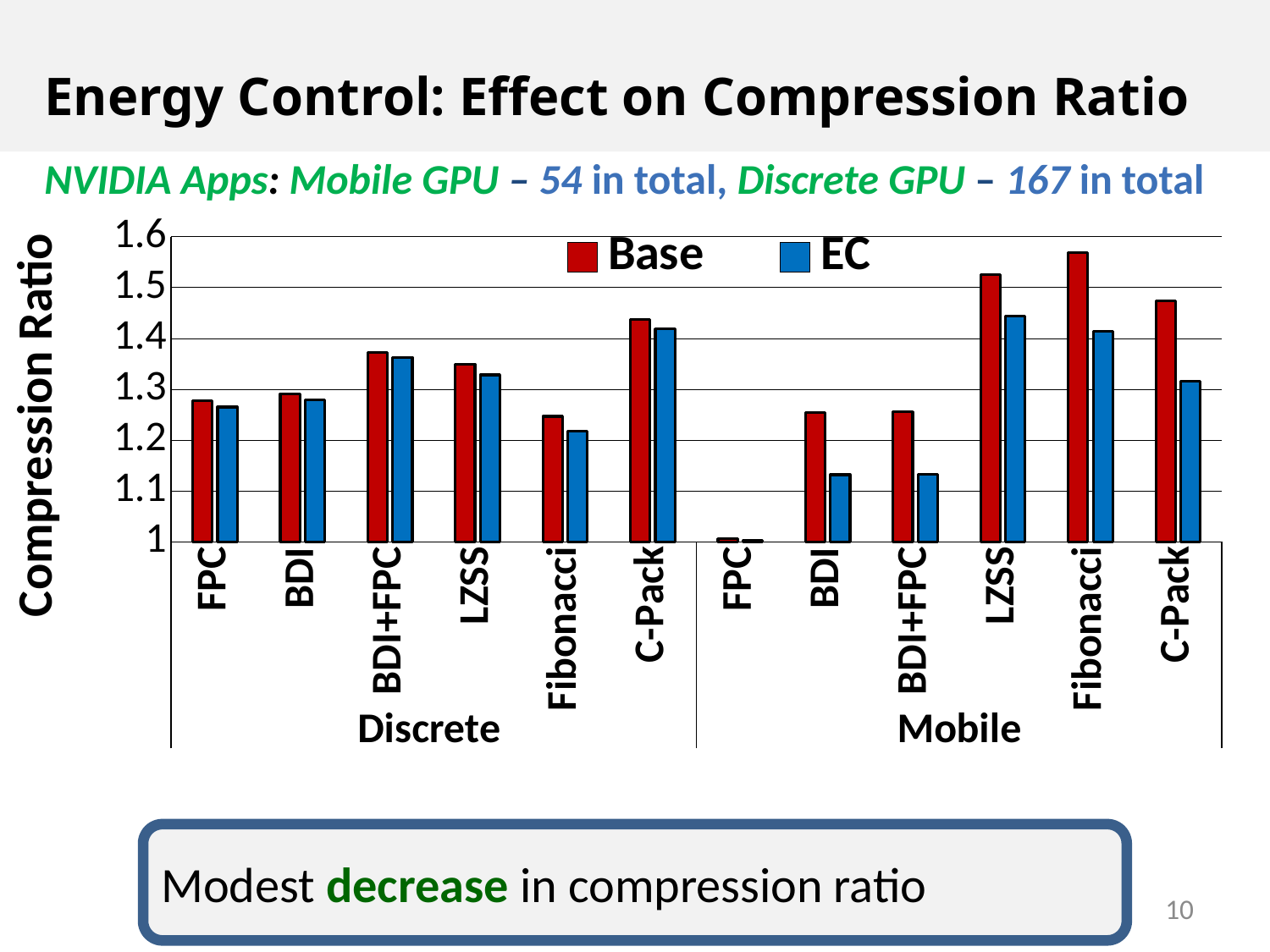
What are the two series named in the legend? Base and EC Which algorithm and group has the lowest Base compression ratio? FPC in Mobile How many series does the legend list? 2 Is the EC value for BDI in the Mobile group greater or less than 1.2? less For C-Pack in the Mobile group, which is larger, the Base value or the EC value? Base What kind of chart is shown on the slide? bar chart How many compression algorithms are plotted within the Discrete group? 6 Is the Base value for LZSS in the Mobile group greater or less than 1.5? greater What is the label on the y axis? Compression Ratio Which algorithm and group has the highest Base compression ratio? Fibonacci in Mobile Is the Base value for C-Pack in the Discrete group greater or less than 1.4? greater